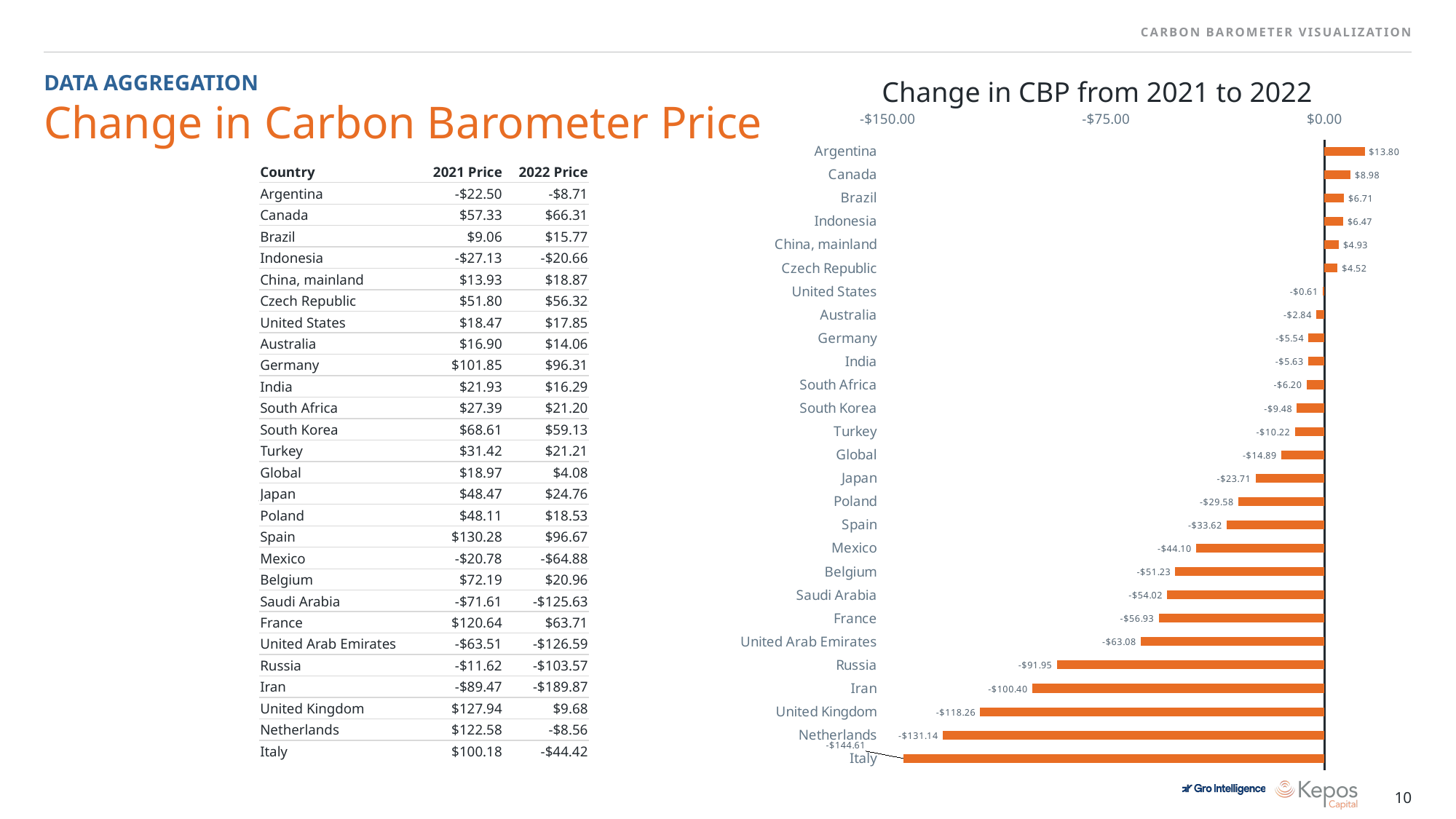
Which has the larger value, Russia or Iran? Russia Which category has the lowest value in the chart? Italy What is the value shown for Mexico in the chart? -$44.10 Which category has the highest value in the chart? Argentina What kind of chart is shown on the slide? Bar chart What is the difference between the values for Netherlands and United Kingdom? $12.88 How many categories are plotted in the chart? 27 What is the value shown for Global in the chart? -$14.89 What is the value shown for Argentina in the chart? $13.80 What is the difference between the values for Argentina and Canada? $4.82 What is the value shown for Italy in the chart? -$144.61 What is the title of the chart? Change in CBP from 2021 to 2022